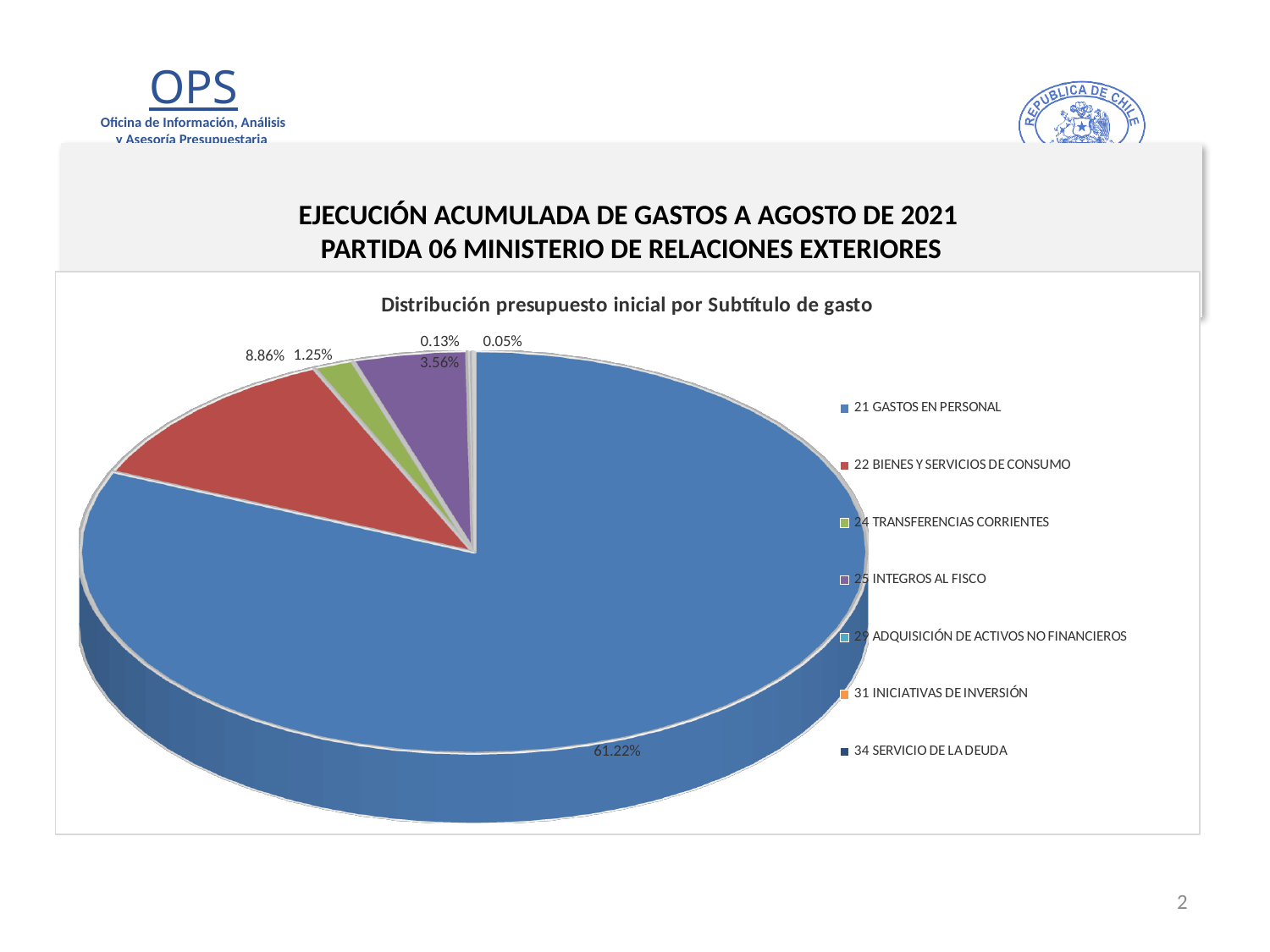
How many categories does the legend of the pie chart list? 7 What is the largest percentage label shown on the pie chart? 61.22% What percentage of the pie is labelled for 25 INTEGROS AL FISCO? 3.56% What percentage of the pie is labelled for 22 BIENES Y SERVICIOS DE CONSUMO? 8.86% What is the difference in percentage points between 25 INTEGROS AL FISCO and 24 TRANSFERENCIAS CORRIENTES? 2.31% What percentage of the pie is labelled for 24 TRANSFERENCIAS CORRIENTES? 1.25% What colour is the slice for 22 BIENES Y SERVICIOS DE CONSUMO? Red Which has the larger share: 24 TRANSFERENCIAS CORRIENTES or 25 INTEGROS AL FISCO? 25 INTEGROS AL FISCO What is the difference in percentage points between 22 BIENES Y SERVICIOS DE CONSUMO and 25 INTEGROS AL FISCO? 5.30% What is the smallest percentage label shown on the pie chart? 0.05% What is the title of the pie chart? Distribución presupuesto inicial por Subtítulo de gasto What kind of chart is shown on the slide? Pie chart